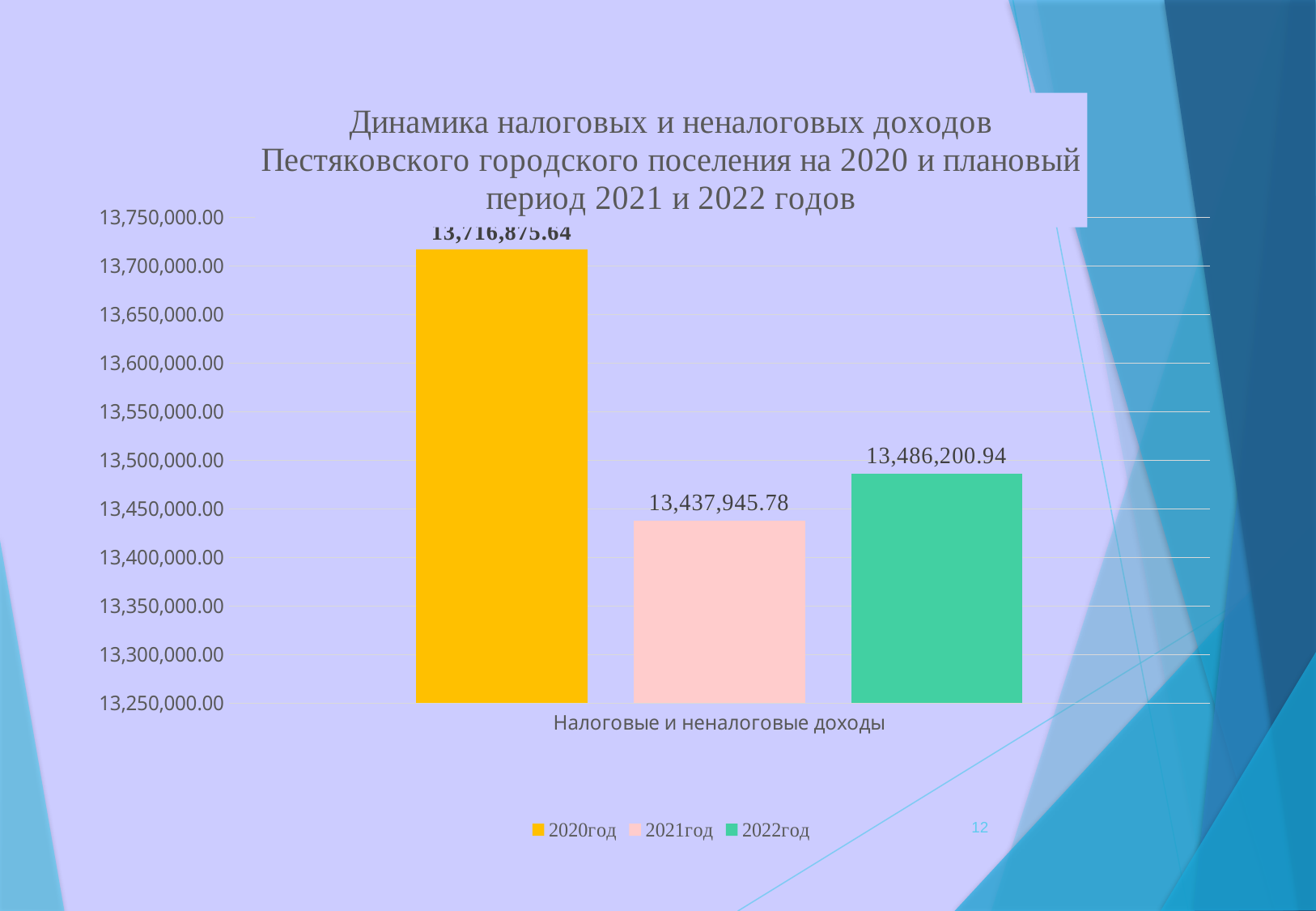
What is the difference between the 2020год and 2021год values? 278,929.86 What is the value for the 2021год series? 13,437,945.78 Which is larger, the value for 2021год or for 2022год? 2022год How many series does the legend list? 3 What is the difference between the 2022год and 2021год values? 48,255.16 What is the value for the 2020год series? 13,716,875.64 Which series has the lowest value? 2021год Is the value for 2021год greater or less than 13,450,000.00? less What is the value for the 2022год series? 13,486,200.94 What kind of chart is shown on the slide? bar chart Which series has the highest value? 2020год What is the category label on the x axis? Налоговые и неналоговые доходы